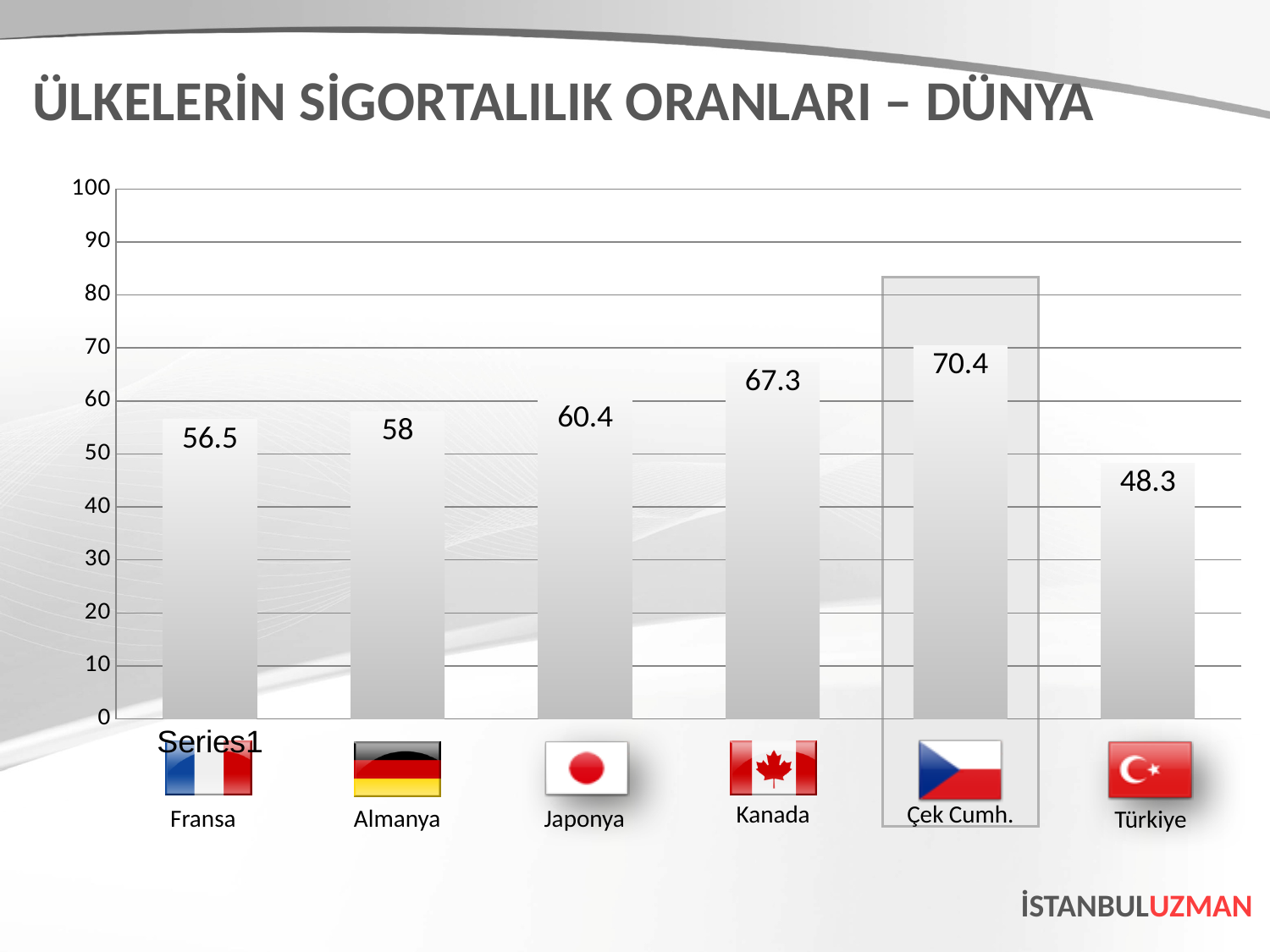
What is the value for Türkiye? 48.3 Which country has the lowest value? Türkiye What is the value for Fransa? 56.5 What is the difference between the values for Çek Cumh. and Türkiye? 22.1 Which is larger, the value for Kanada or the value for Japonya? Kanada What is the value for Kanada? 67.3 Which country has the highest value? Çek Cumh. How many countries are shown in the chart? 6 What kind of chart is shown on the slide? bar chart What is the title of the slide? ÜLKELERİN SİGORTALILIK ORANLARI – DÜNYA Is the value for Almanya greater or less than 50? greater What is the difference between the values for Japonya and Almanya? 2.4